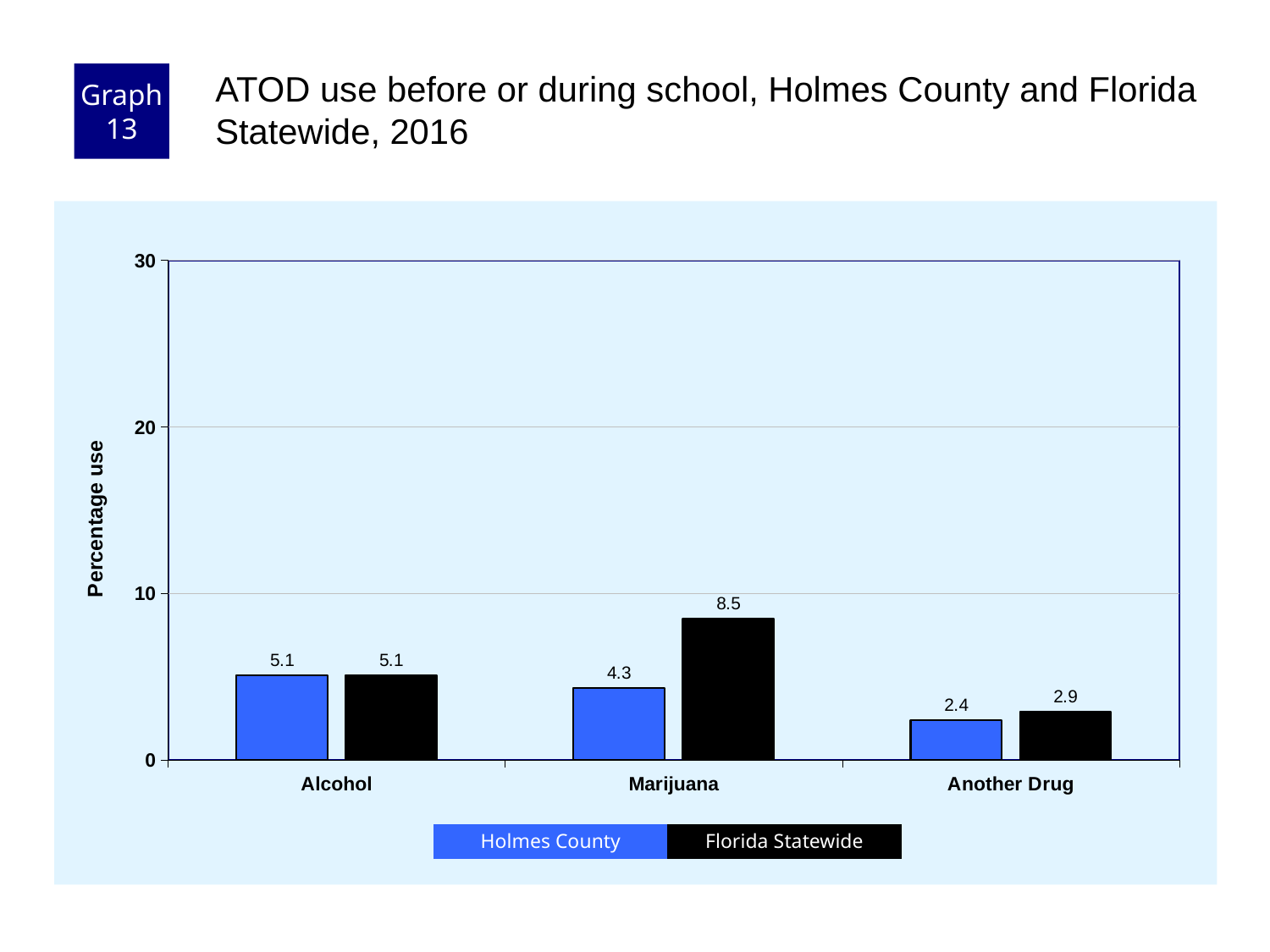
What is the Florida Statewide value for Another Drug? 2.9 How many series does the legend list? 2 What is the Holmes County value for Marijuana? 4.3 Is the Florida Statewide value for Marijuana greater or less than 10? less Which is larger for Another Drug, Holmes County or Florida Statewide? Florida Statewide Which category has the lowest Holmes County value? Another Drug What is the Holmes County value for Alcohol? 5.1 How many categories are shown on the x axis? 3 What is the label of the y axis? Percentage use Which category has the highest Florida Statewide value? Marijuana What is the difference between the Florida Statewide and Holmes County values for Marijuana? 4.2 What kind of chart is shown on the slide? bar chart